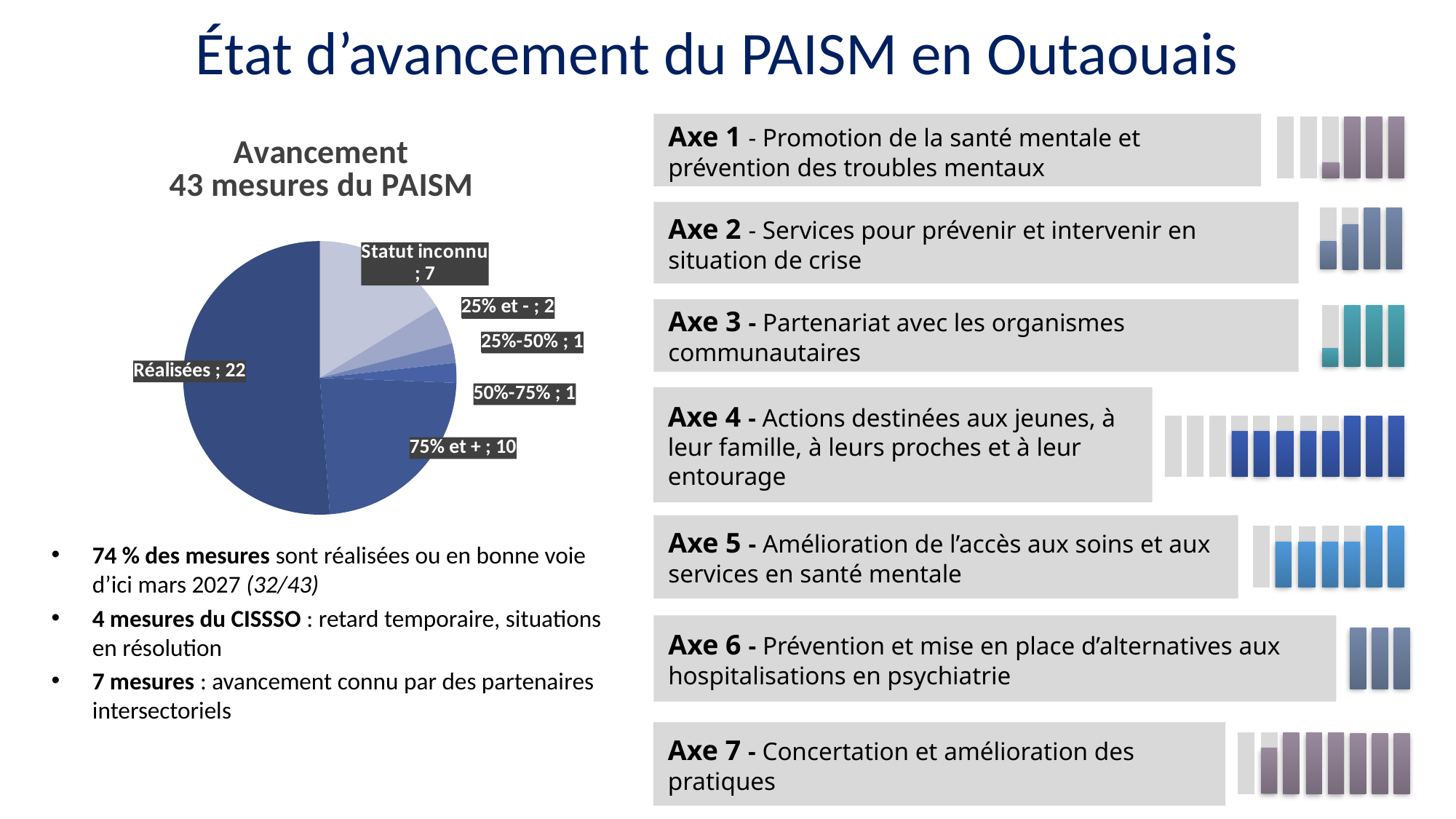
How many categories (slices) does the pie chart have? 6 In the pie chart, which has more measures: "Statut inconnu" or "25% et -"? Statut inconnu What is the difference between the number of "Réalisées" measures and the number of "75% et +" measures in the pie chart? 12 What type of chart is shown on the left of the slide? Pie chart What is the total number of measures represented in the pie chart? 43 In the pie chart, how many measures are in the "75% et +" category? 10 In the pie chart, how many measures have "Statut inconnu"? 7 What is the title of the pie chart? Avancement 43 mesures du PAISM In the pie chart, how many measures are in the "50%-75%" category? 1 In the pie chart, how many measures are in the "25% et -" category? 2 In the pie chart, how many measures are labelled "Réalisées"? 22 Which category in the pie chart has the largest number of measures? Réalisées